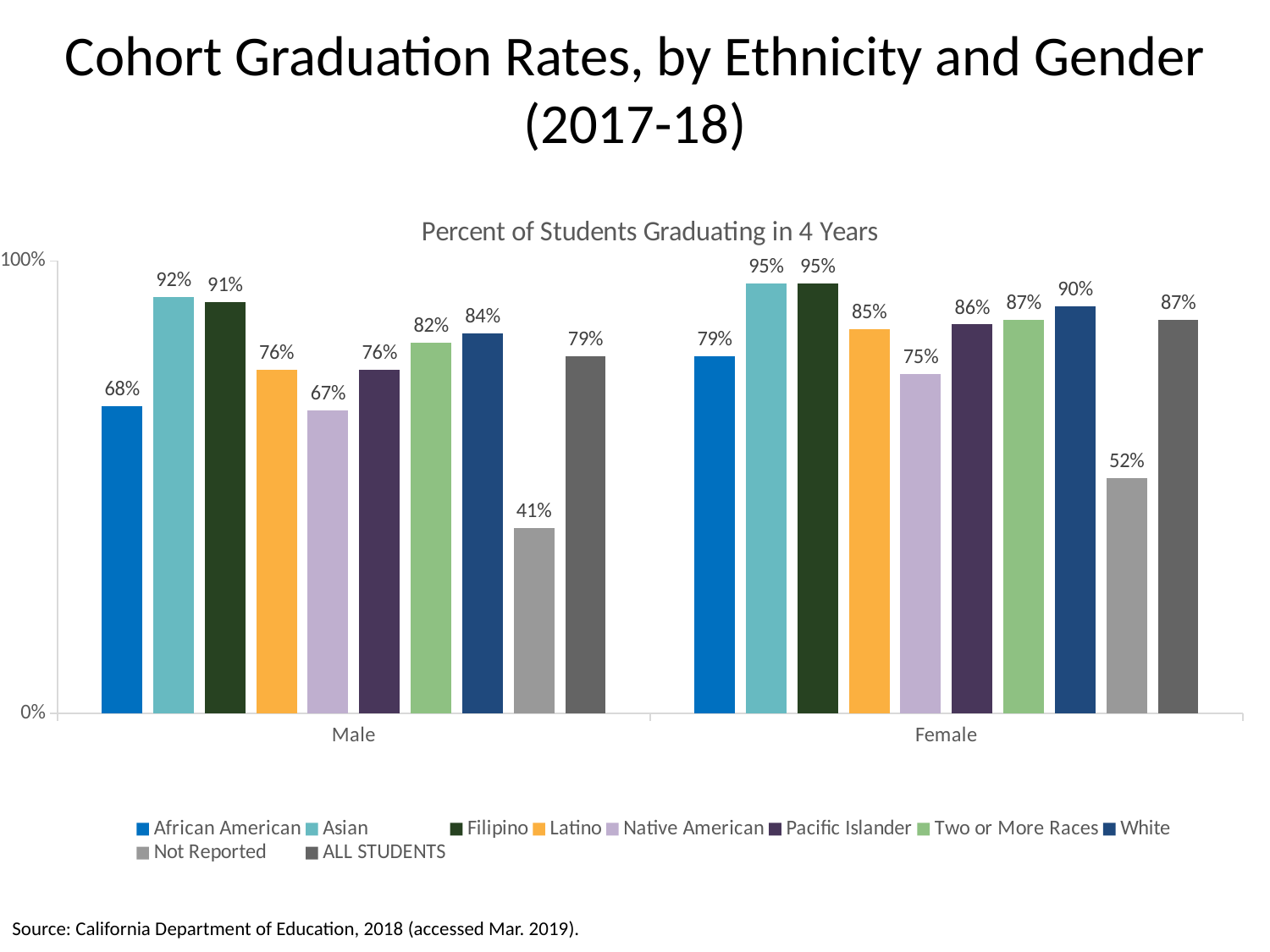
Which series has the lowest graduation rate in the Male group? Not Reported What is the difference between the White female and White male graduation rates? 6% What is the title shown above the plot area of the chart? Percent of Students Graduating in 4 Years Which is larger, the Latino female graduation rate or the Native American female graduation rate? Latino female What is the graduation rate for African American male students? 68% What is the difference between the Asian male graduation rate and the African American male graduation rate? 24% What is the graduation rate for ALL STUDENTS in the Female group? 87% How many series does the legend list? 10 What is the graduation rate for Not Reported female students? 52% What kind of chart is shown on the slide? Bar chart How many groups are shown on the x axis? 2 Which series has the highest graduation rate in the Male group? Asian